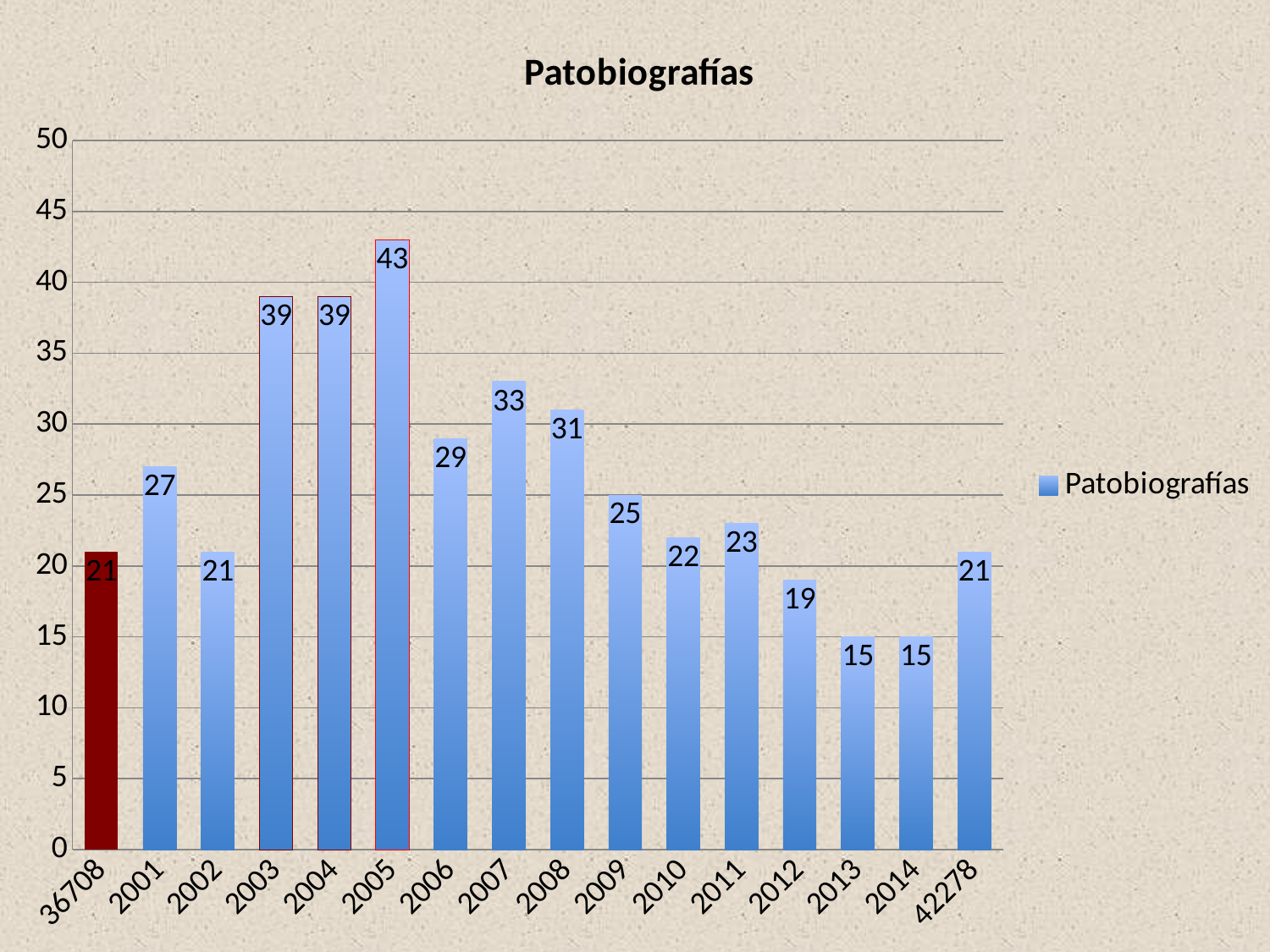
How many series does the legend list? 1 What is the value for 2007? 33 What is the difference between the values for 2005 and 2006? 14 What is the value for 2012? 19 Which category has the highest value? 2005 What is the title of the chart? Patobiografías How many categories are shown on the x axis? 16 Which is larger, the value for 2008 or the value for 2009? 2008 Do the values rise or fall from 2005 to 2013? fall What is the value for 2005? 43 What kind of chart is shown? bar chart Is the value for 2001 greater or less than 25? greater